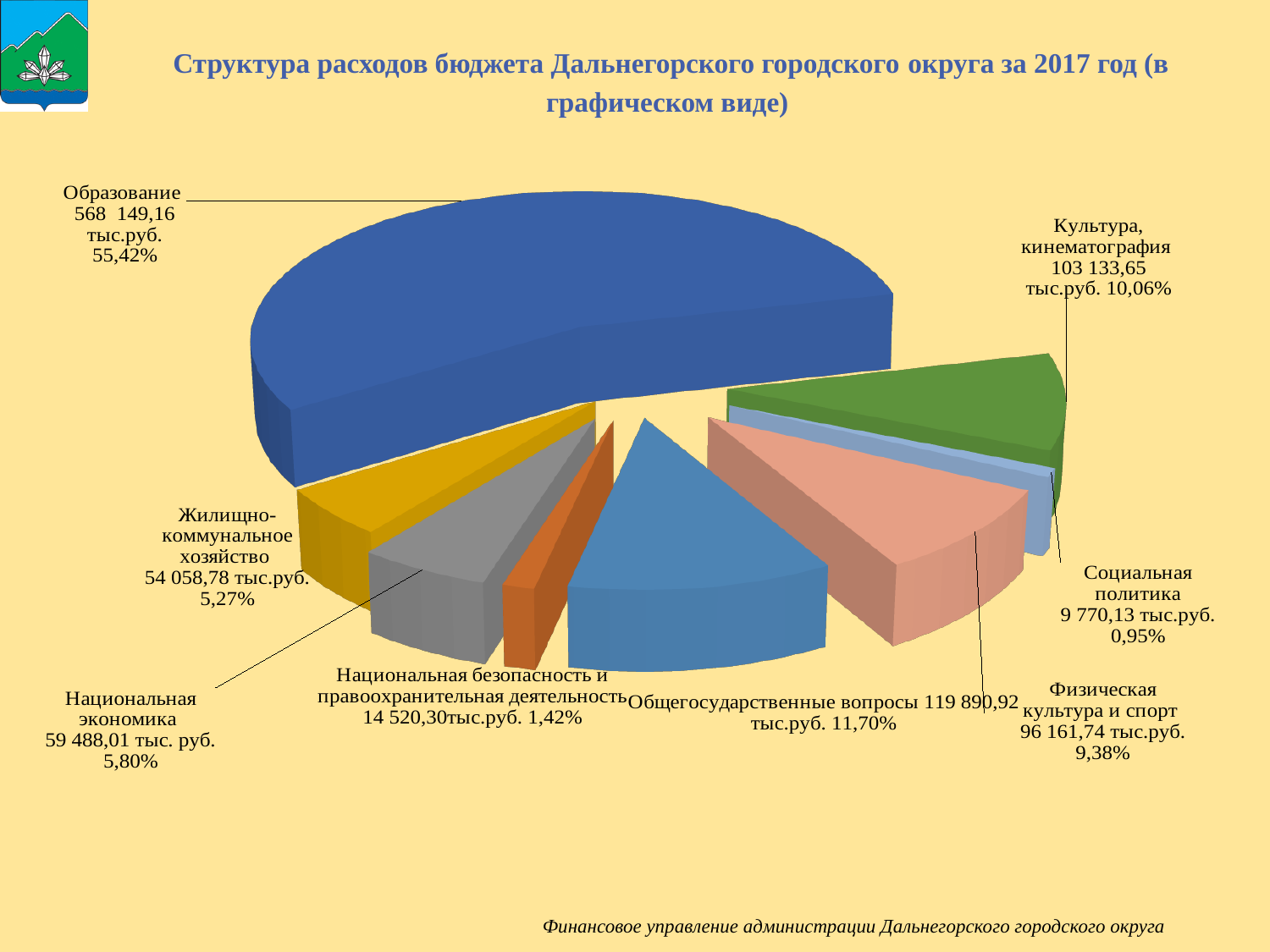
Which category has the largest slice? Образование What kind of chart is shown on the slide? pie chart Which category has the smallest slice? Социальная политика How many slices does the pie chart have? 8 What is the value for Национальная безопасность и правоохранительная деятельность? 14 520,30 тыс.руб. What share of the pie does Социальная политика represent? 0,95% What is the value for Общегосударственные вопросы? 119 890,92 тыс.руб. What is the value for Образование? 568 149,16 тыс.руб. Which is larger, Культура, кинематография or Физическая культура и спорт? Культура, кинематография What share of the pie does Образование represent? 55,42% What is the difference in percentage share between Национальная экономика and Жилищно-коммунальное хозяйство? 0,53% What is the title of the chart on the slide? Структура расходов бюджета Дальнегорского городского округа за 2017 год (в графическом виде)